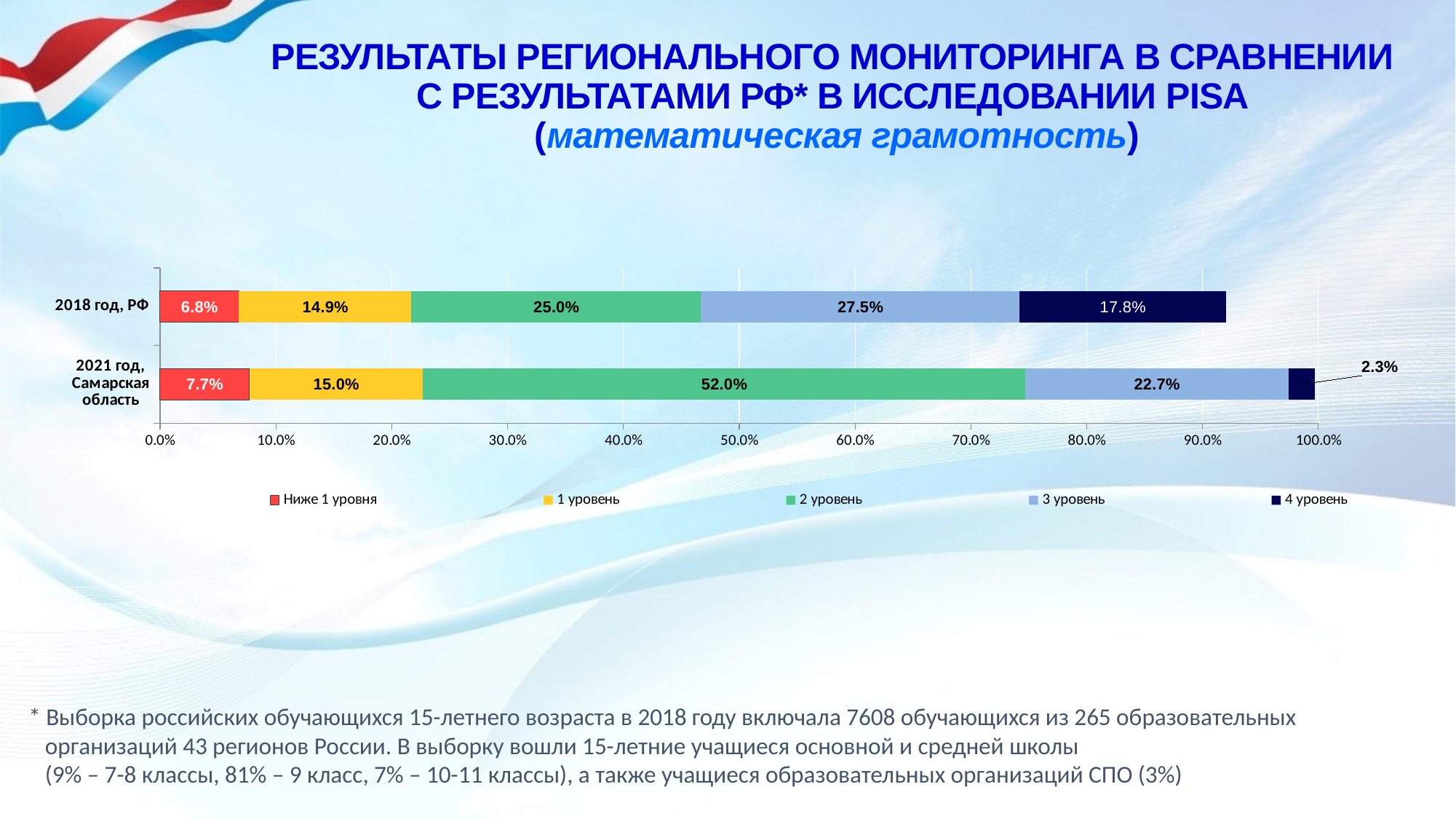
How many categories (bars) are shown in the chart? 2 Which is larger: the "4 уровень" value for "2018 год, РФ" or for "2021 год, Самарская область"? 2018 год, РФ What kind of chart is shown on the slide? Stacked bar chart Which level has the largest share in the "2021 год, Самарская область" bar? 2 уровень What is the difference between the "2 уровень" values for "2021 год, Самарская область" and "2018 год, РФ"? 27.0% What is the value of "4 уровень" for "2018 год, РФ"? 17.8% What is the total of the stacked bar for "2018 год, РФ"? 92.0% What is the value of "2 уровень" for "2021 год, Самарская область"? 52.0% How many series does the legend list? 5 What is the value of "Ниже 1 уровня" for "2021 год, Самарская область"? 7.7% Which level has the smallest share in the "2018 год, РФ" bar? Ниже 1 уровня What is the value of "3 уровень" for "2018 год, РФ"? 27.5%